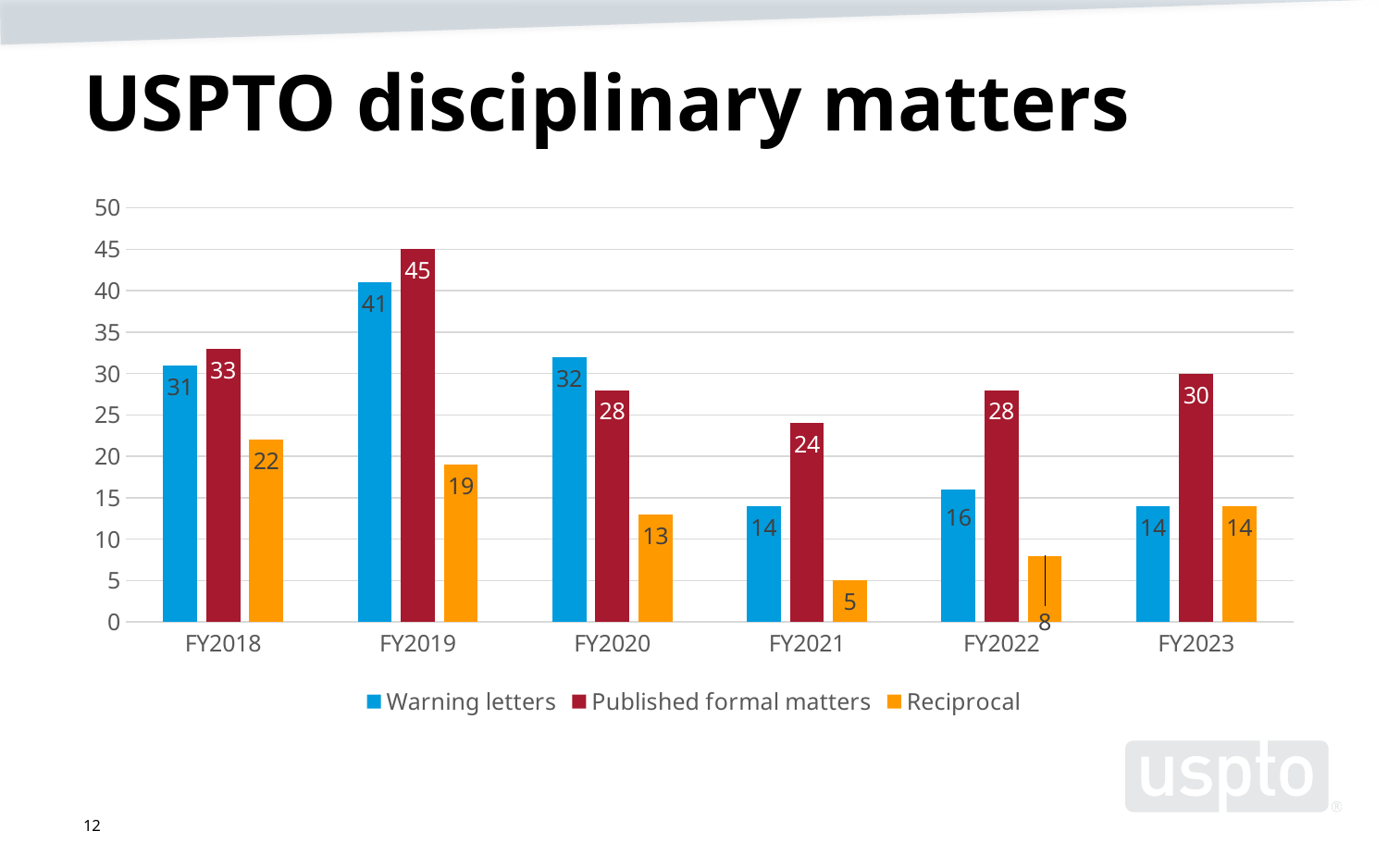
What is the value for Warning letters in FY2019? 41 Which fiscal year has the lowest value for Reciprocal? FY2021 What is the difference between Published formal matters and Warning letters in FY2021? 10 Which is larger in FY2020: Warning letters or Published formal matters? Warning letters Is the value for Published formal matters in FY2019 greater or less than 40? greater What kind of chart is shown on the slide? Bar chart Which fiscal year has the highest value for Published formal matters? FY2019 What is the value for Reciprocal in FY2021? 5 What is the value for Published formal matters in FY2023? 30 How many series does the legend list? 3 How many fiscal years are shown on the x axis? 6 What is the title of the chart? USPTO disciplinary matters